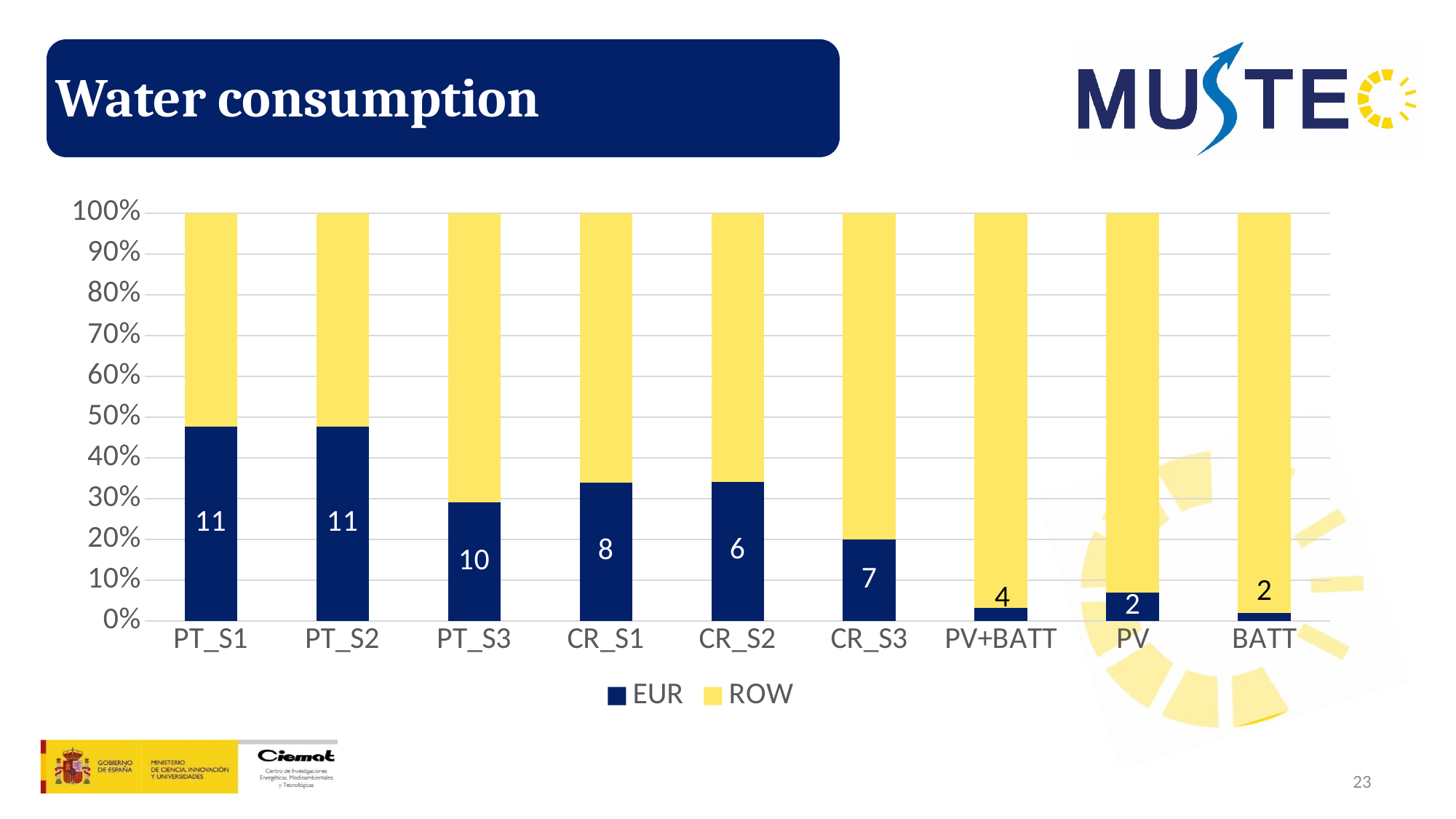
What kind of chart is shown on the slide? Stacked bar chart What is the EUR data label for CR_S2? 6 Is the EUR share of the PV+BATT bar greater or less than 10%? less How many series does the legend list? 2 Is the EUR share of the PT_S1 bar greater or less than 50%? less What is the EUR data label for BATT? 2 What is the EUR data label for PT_S1? 11 How many categories are shown on the x axis? 9 Is the EUR share of the CR_S1 bar greater or less than 30%? greater What is the EUR data label for PV+BATT? 4 What is the difference between the EUR data labels for PT_S1 and CR_S2? 5 Which has the larger EUR data label, PT_S3 or CR_S1? PT_S3